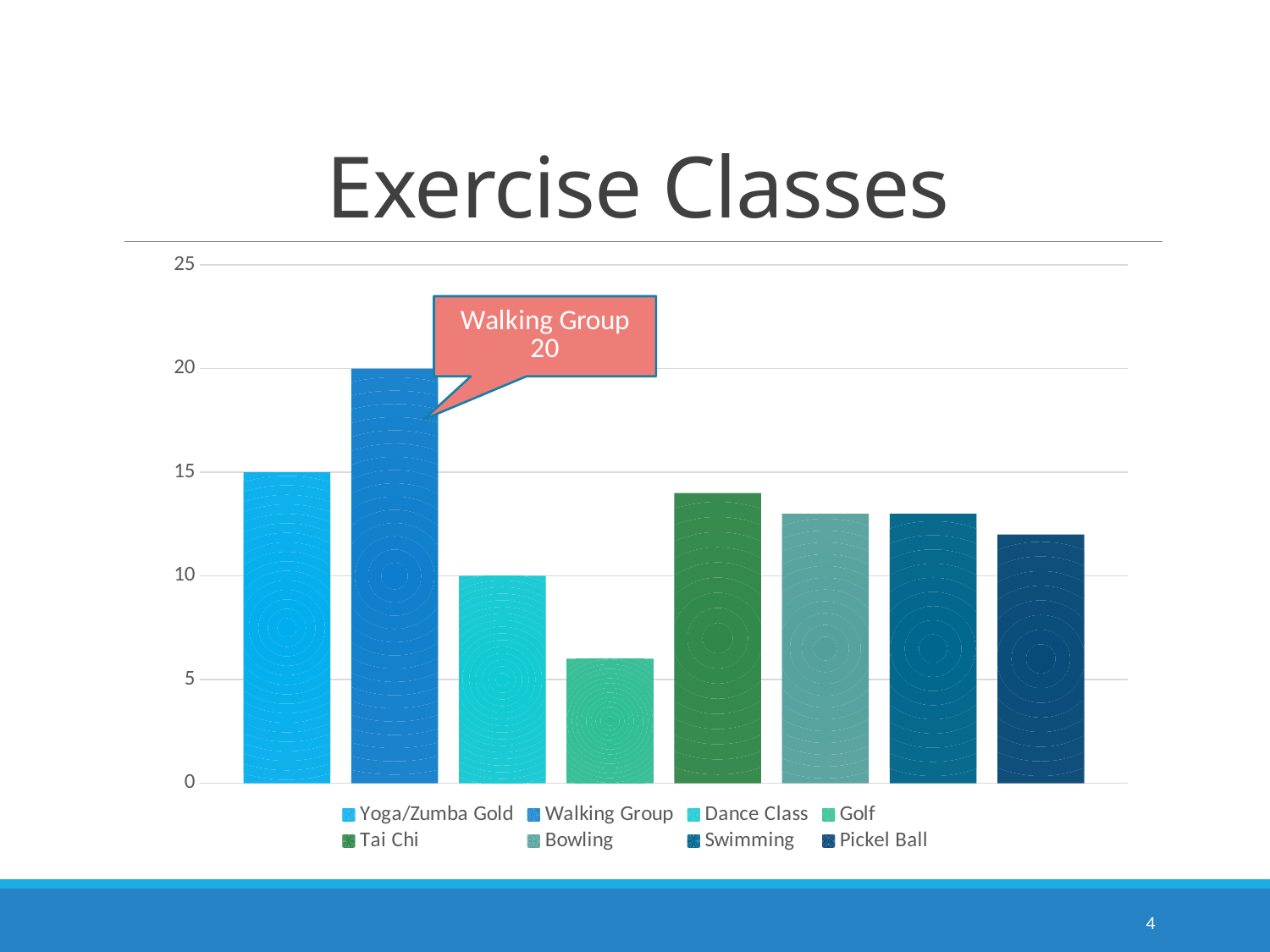
Which category has the lowest value? Golf Which is larger, the value for Yoga/Zumba Gold or the value for Dance Class? Yoga/Zumba Gold Is the value for Tai Chi greater or less than 10? greater What kind of chart is shown on the slide? Bar chart How many categories are plotted in the chart? 8 What is the title of the slide containing the chart? Exercise Classes Which is larger, the value for Tai Chi or the value for Golf? Tai Chi Which category has the highest value? Walking Group Is the value for Golf greater or less than 10? less What is the value for Walking Group? 20 How many entries does the legend list? 8 Is the value for Pickel Ball greater or less than 10? greater